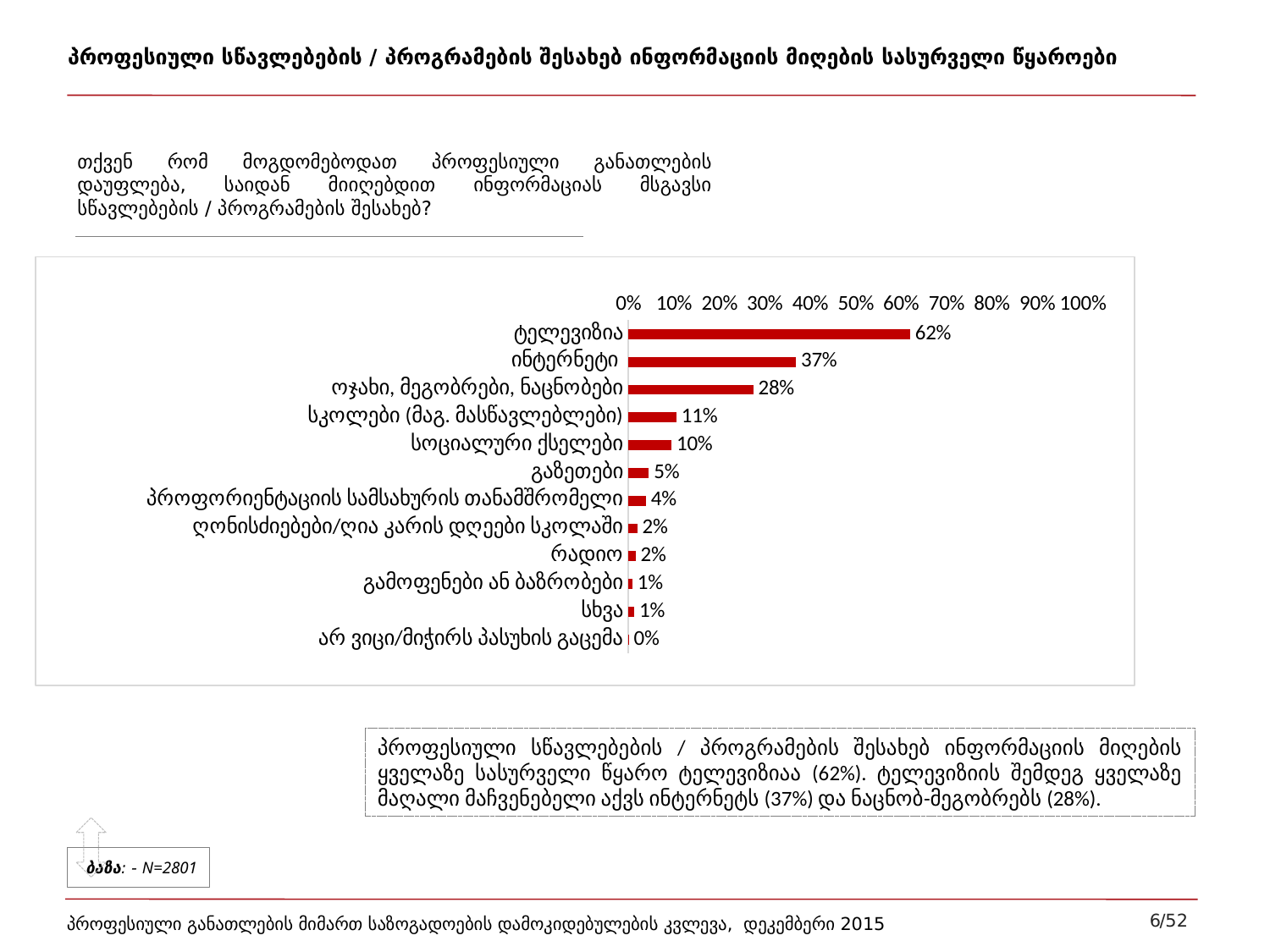
What is the value for ტელევიზია? 62% What is the difference between the values for ოჯახი, მეგობრები, ნაცნობები and სკოლები (მაგ. მასწავლებლები)? 17% Is the value for ტელევიზია greater or less than 50%? greater Which category has the lowest value? არ ვიცი/მიჭირს პასუხის გაცემა What is the value for ინტერნეტი? 37% How many categories are shown in the chart? 12 What is the difference between the values for ტელევიზია and ინტერნეტი? 25% What is the value for სოციალური ქსელები? 10% Which is larger, the value for ინტერნეტი or the value for ოჯახი, მეგობრები, ნაცნობები? ინტერნეტი What kind of chart is shown on the slide? bar chart Which category has the highest value? ტელევიზია What is the value for გაზეთები? 5%